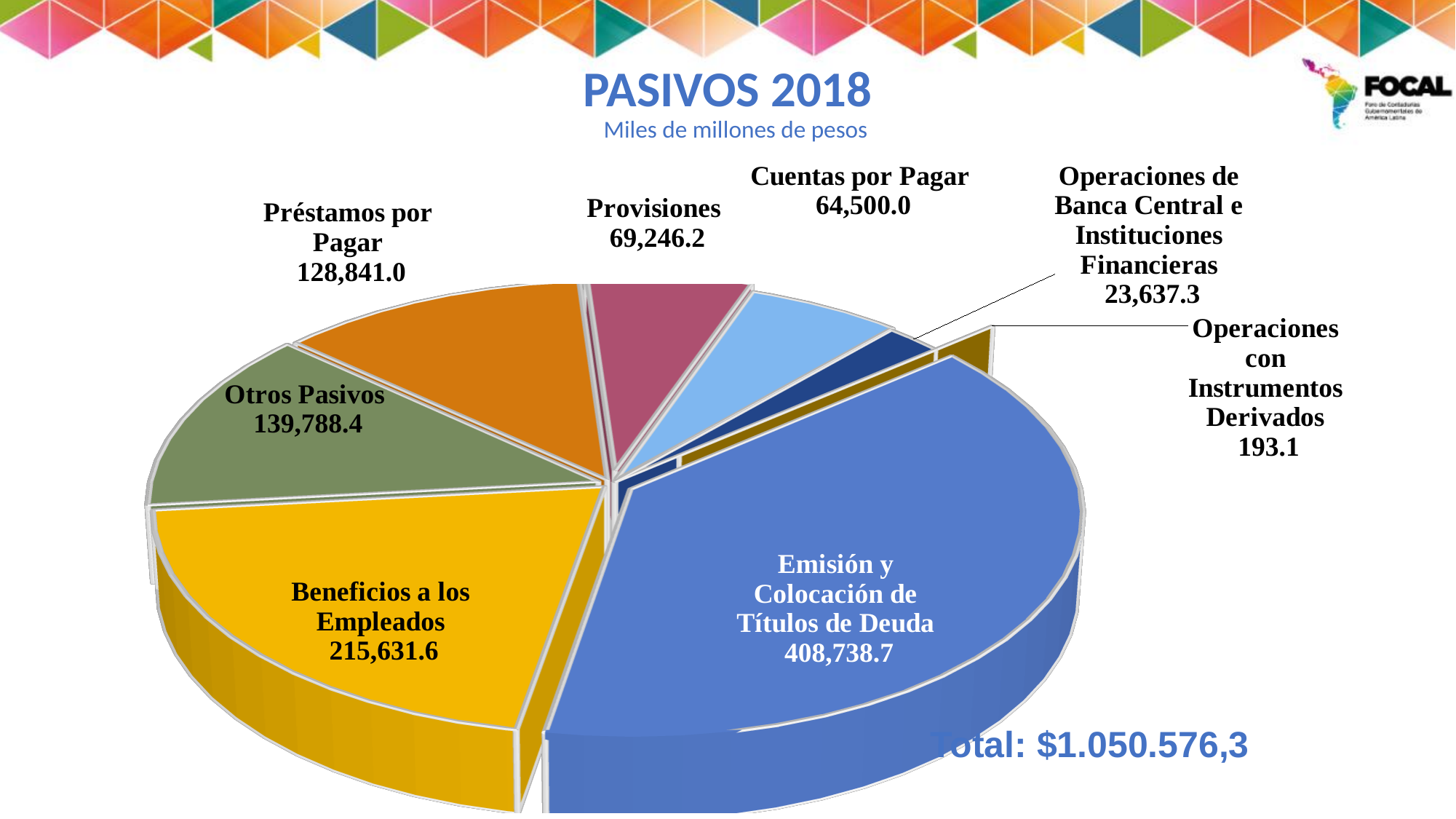
What is the value for Beneficios a los Empleados? 215,631.6 What is the difference between Emisión y Colocación de Títulos de Deuda and Beneficios a los Empleados? 193,107.1 What is the value for Emisión y Colocación de Títulos de Deuda? 408,738.7 Which category has the smallest value? Operaciones con Instrumentos Derivados What is the value for Operaciones de Banca Central e Instituciones Financieras? 23,637.3 What type of chart is shown on the slide? Pie chart Which is larger, Provisiones or Cuentas por Pagar? Provisiones What unit is stated in the subtitle of the chart? Miles de millones de pesos Which category has the largest value? Emisión y Colocación de Títulos de Deuda What is the difference between Otros Pasivos and Préstamos por Pagar? 10,947.4 How many categories does the pie chart show? 8 What is the value for Provisiones? 69,246.2